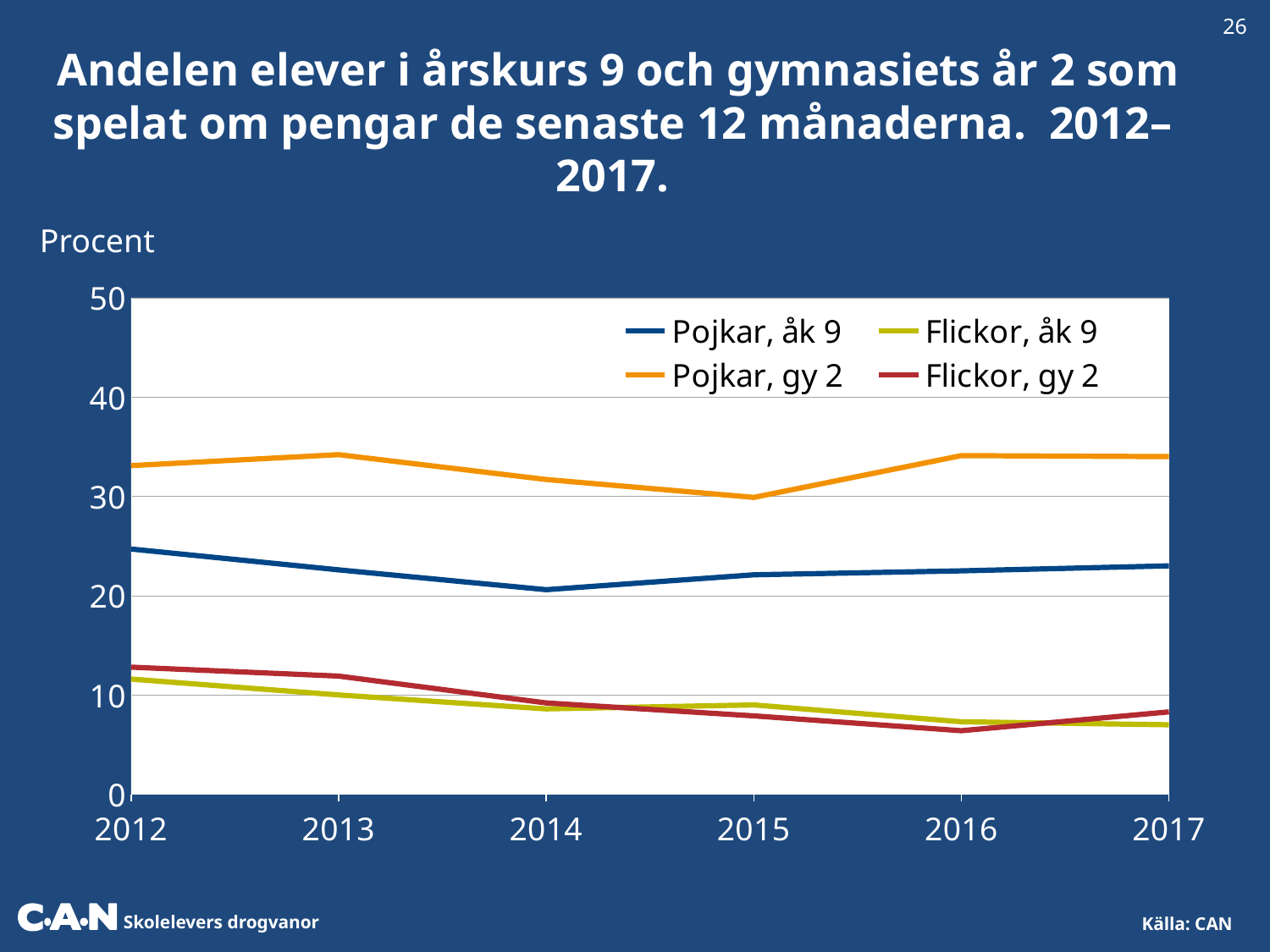
Is the value for Pojkar, gy 2 in 2013 greater or less than 30? greater Which series has the lowest value in 2012? Flickor, åk 9 How many years are shown along the x axis? 6 Is the value for Pojkar, åk 9 in 2012 greater or less than 20? greater What unit label is shown above the y axis of the chart? Procent Which series has the highest value in 2017? Pojkar, gy 2 How many series does the legend list? 4 Is the value for Flickor, gy 2 in 2016 greater or less than 10? less In 2015, which is larger: the value for Pojkar, åk 9 or the value for Flickor, gy 2? Pojkar, åk 9 What kind of chart is shown on the slide? Line chart Does the value for Pojkar, åk 9 rise or fall from 2012 to 2014? Fall Does the value for Flickor, gy 2 rise or fall from 2012 to 2016? Fall